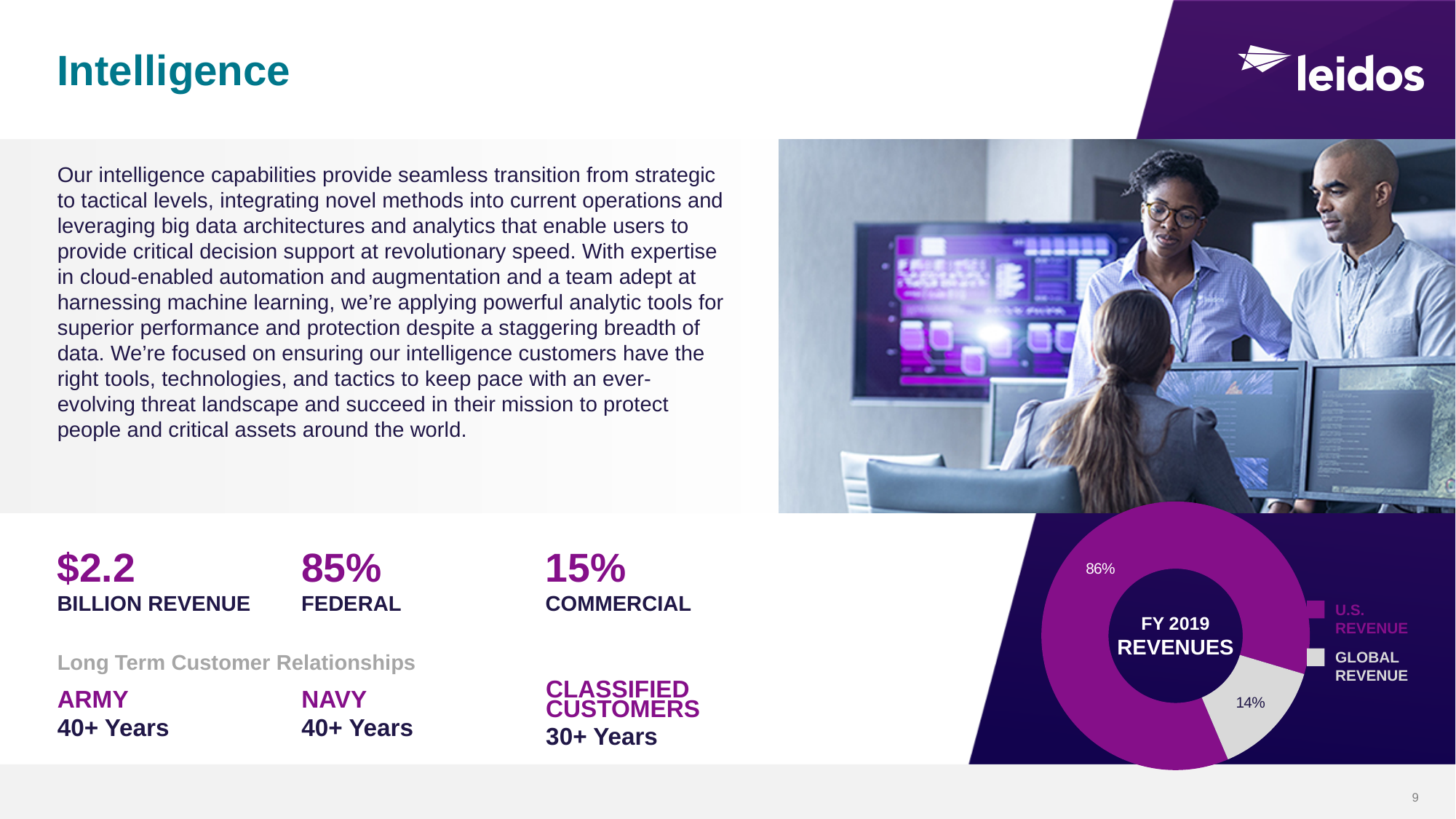
What share of FY 2019 revenues is Global Revenue? 14% How many slices does the FY 2019 Revenues chart have? 2 Which is larger in the FY 2019 Revenues chart, U.S. Revenue or Global Revenue? U.S. Revenue Which slice of the FY 2019 Revenues chart is the largest? U.S. Revenue What kind of chart is shown on the slide? Pie chart (donut) Which slice of the FY 2019 Revenues chart is the smallest? Global Revenue What is the difference in percentage points between the U.S. Revenue and Global Revenue slices? 72 percentage points How many entries does the legend of the FY 2019 Revenues chart list? 2 What share of FY 2019 revenues is U.S. Revenue? 86% What is the title shown in the centre of the chart? FY 2019 REVENUES What colour is the Global Revenue slice in the FY 2019 Revenues chart? Light grey